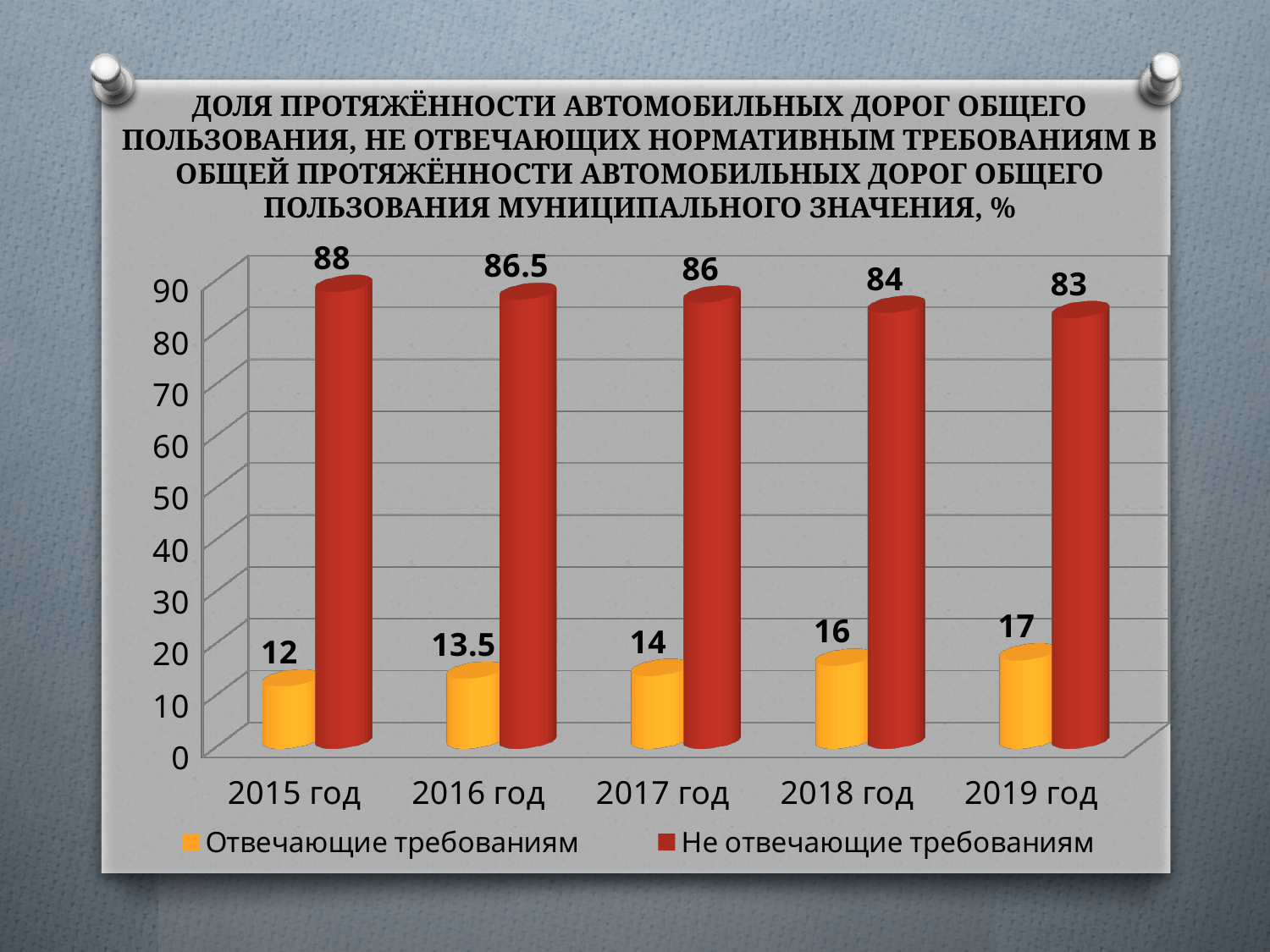
Which is larger: the "Отвечающие требованиям" value for 2018 год or for 2017 год? 2018 год How many years are shown on the x axis? 5 How many series does the legend list? 2 What kind of chart is shown on the slide? bar chart Do the values for "Не отвечающие требованиям" rise or fall from 2015 год to 2019 год? fall What is the value for "Не отвечающие требованиям" in 2015 год? 88 In which year is the value for "Отвечающие требованиям" highest? 2019 год What is the value for "Отвечающие требованиям" in 2016 год? 13.5 In which year is the value for "Не отвечающие требованиям" lowest? 2019 год What colour are the bars for "Отвечающие требованиям"? orange What is the difference between the "Не отвечающие требованиям" values for 2015 год and 2019 год? 5 What is the value for "Не отвечающие требованиям" in 2019 год? 83